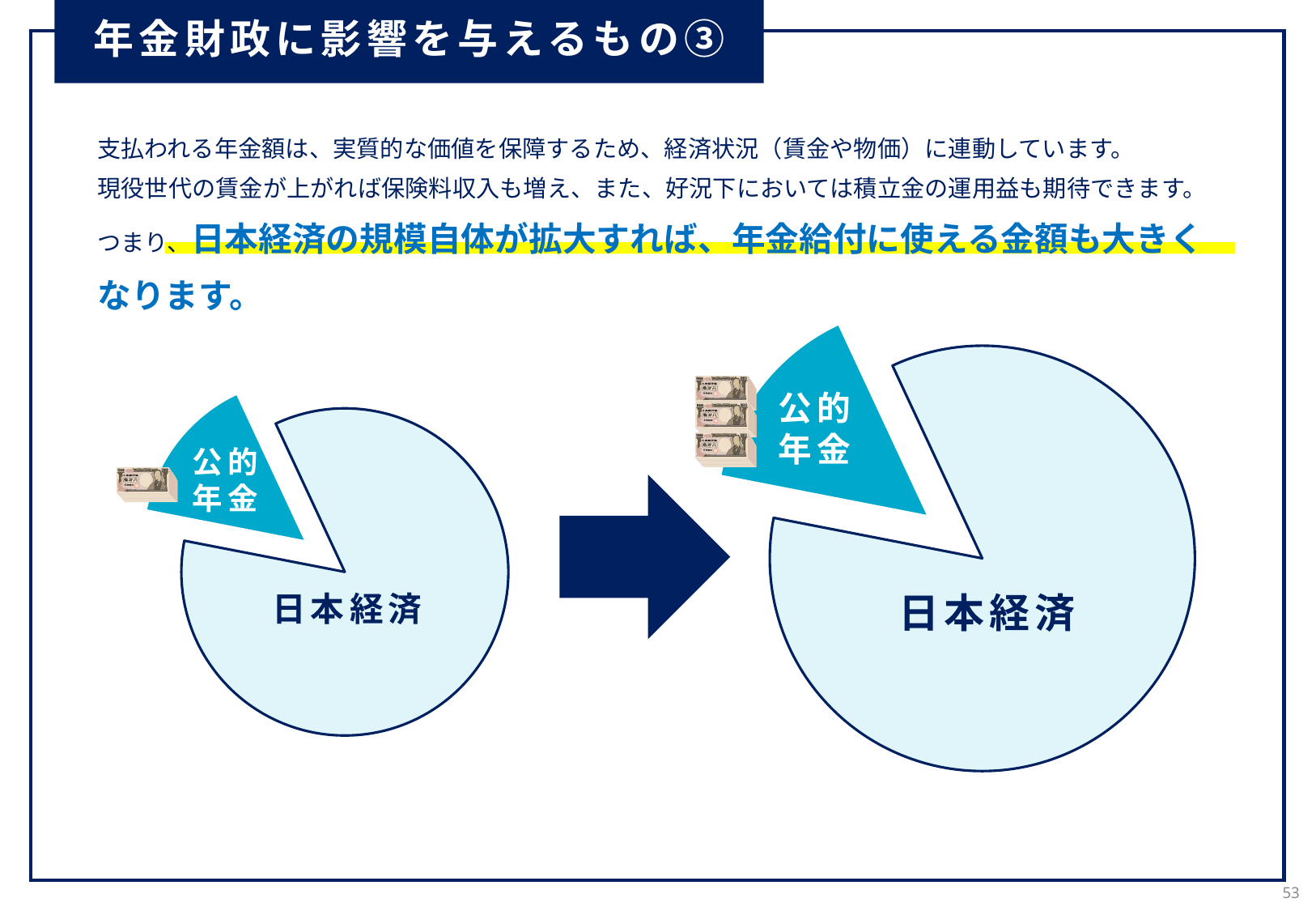
In the left pie chart, which slice is larger, 公的年金 or 日本経済? 日本経済 What is the label of the pulled-out (exploded) slice in the left pie chart? 公的年金 What kind of chart is shown on the right side of the slide? pie chart How many slices does the left pie chart have? 2 In the right pie chart, which slice is the largest? 日本経済 What kind of chart is shown on the left side of the slide? pie chart How many slices does the right pie chart have? 2 Which of the two pie charts is drawn larger, the left one or the right one? the right one In the left pie chart, which slice is the smallest? 公的年金 In the right pie chart, which slice is larger, 公的年金 or 日本経済? 日本経済